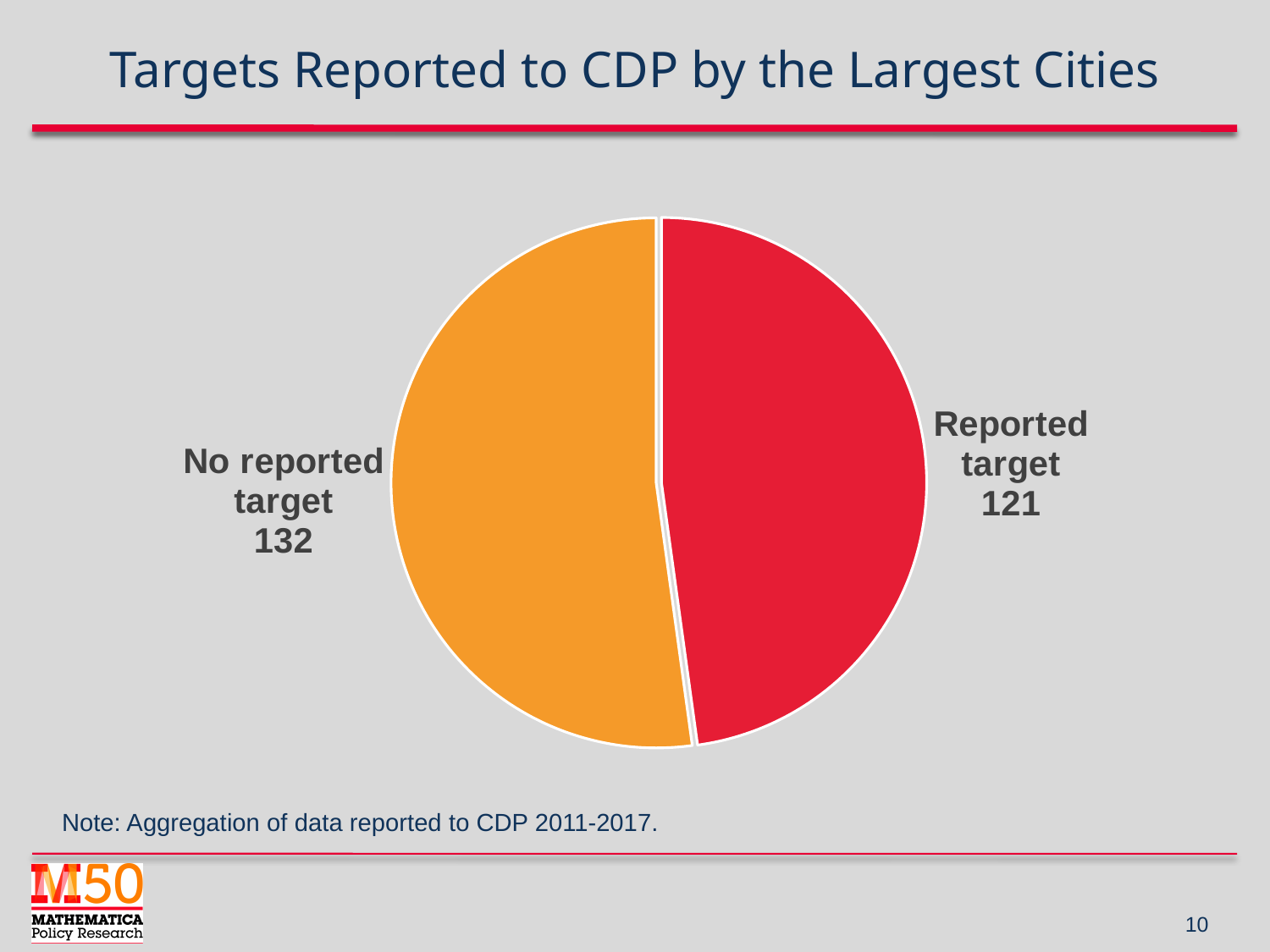
Which slice is the smallest? Reported target What is the value for "Reported target"? 121 Which is larger, "Reported target" or "No reported target"? No reported target What is the title of the chart? Targets Reported to CDP by the Largest Cities What kind of chart is shown on the slide? Pie chart Which slice is the largest? No reported target What colour is the "Reported target" slice? Red What share of the pie does the "No reported target" slice represent? 52.2% How many slices does the pie chart have? 2 What is the difference between the "No reported target" and "Reported target" values? 11 What is the value for "No reported target"? 132 What is the total of the two slices in the pie chart? 253